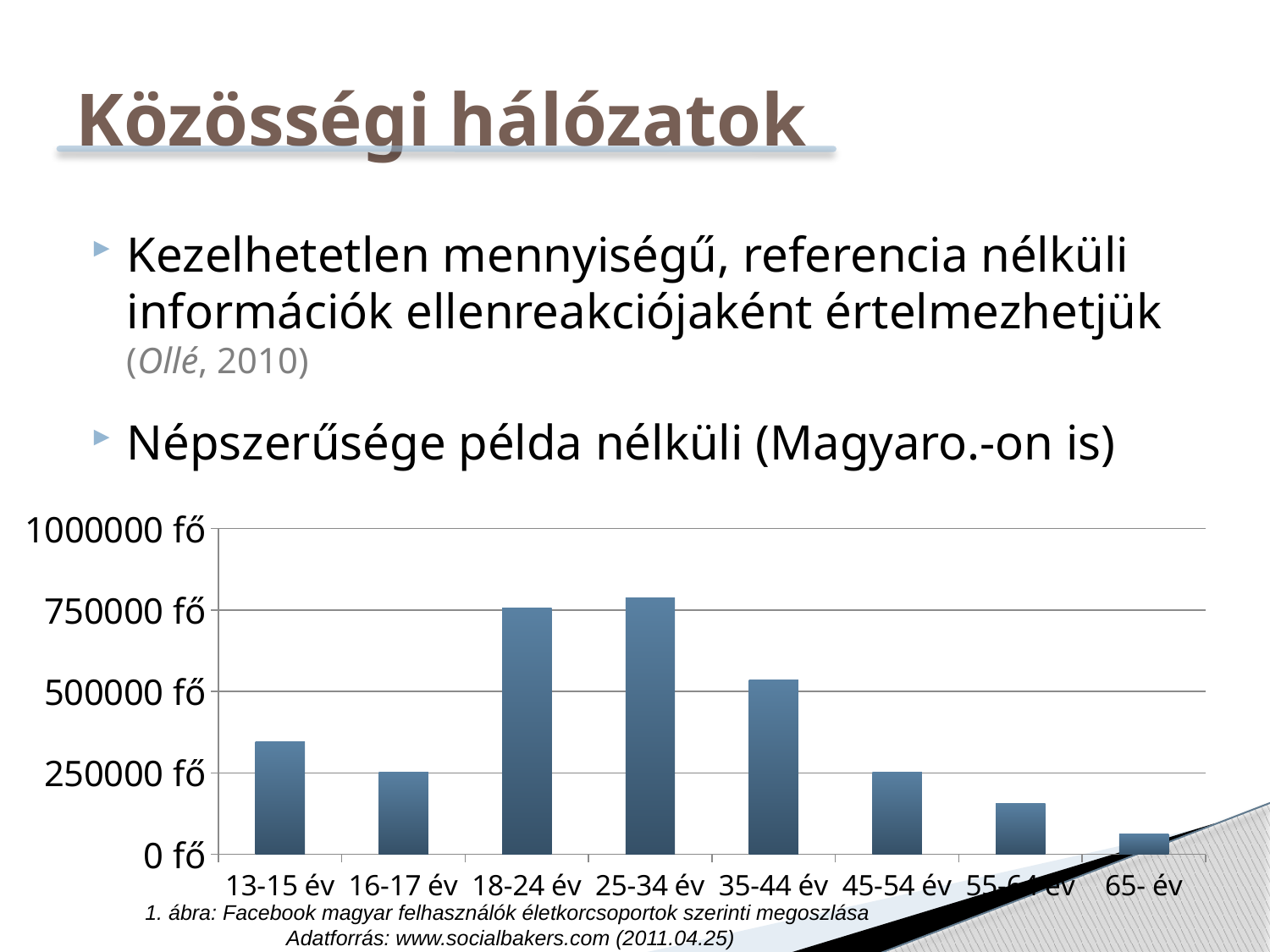
Which age group has the lowest value in the chart? 65- év Is the value for 25-34 év greater or less than 750000 fő? greater Is the value for 13-15 év greater or less than 250000 fő? greater Which has the larger value, 35-44 év or 45-54 év? 35-44 év What kind of chart is shown on the slide? bar chart Which has the larger value, 13-15 év or 16-17 év? 13-15 év Do the values rise or fall along the x axis from 25-34 év to 65- év? fall According to the caption, what is the data source of the chart? www.socialbakers.com (2011.04.25) Which age group has the highest value in the chart? 25-34 év How many age-group categories are shown on the x axis of the chart? 8 Is the value for 35-44 év greater or less than 500000 fő? greater